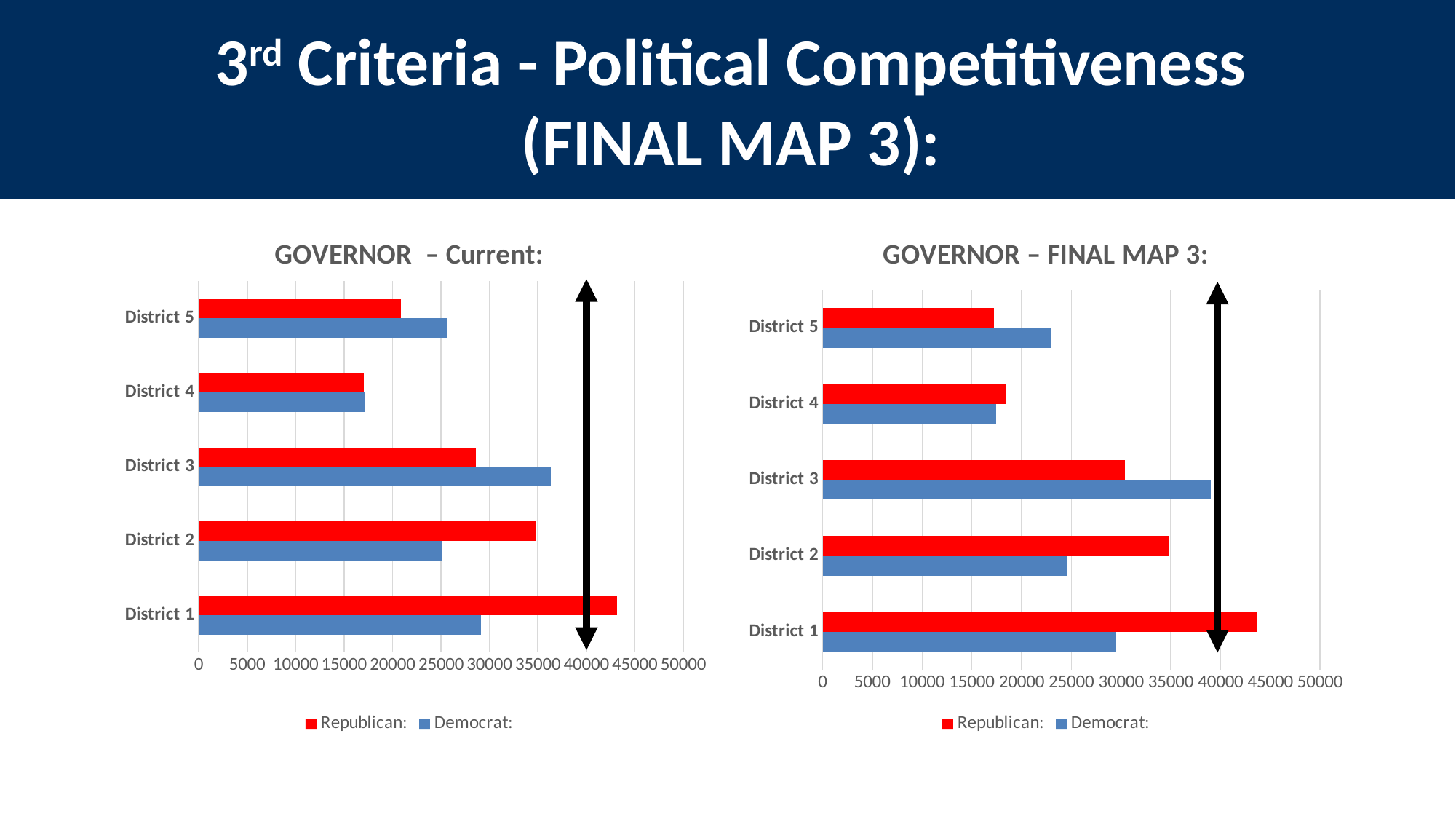
What type of chart is the GOVERNOR – Current chart? Bar chart In the GOVERNOR – Current chart, which district has the highest Republican value? District 1 In the GOVERNOR – FINAL MAP 3 chart, is the Republican value for District 1 greater or less than 40000? greater In the GOVERNOR – Current chart, which is larger for District 2, the Republican value or the Democrat value? Republican In the GOVERNOR – FINAL MAP 3 chart, which is larger for District 5, the Republican value or the Democrat value? Democrat In the GOVERNOR – FINAL MAP 3 chart, is the Republican value for District 5 greater or less than 20000? less How many districts are shown in the GOVERNOR – FINAL MAP 3 chart? 5 In the GOVERNOR – FINAL MAP 3 chart, which district has the highest Democrat value? District 3 How many series does the legend of the GOVERNOR – Current chart list? 2 In the GOVERNOR – Current chart, which district has the lowest Republican value? District 4 In the GOVERNOR – Current chart, is the Republican value for District 1 greater or less than 40000? greater